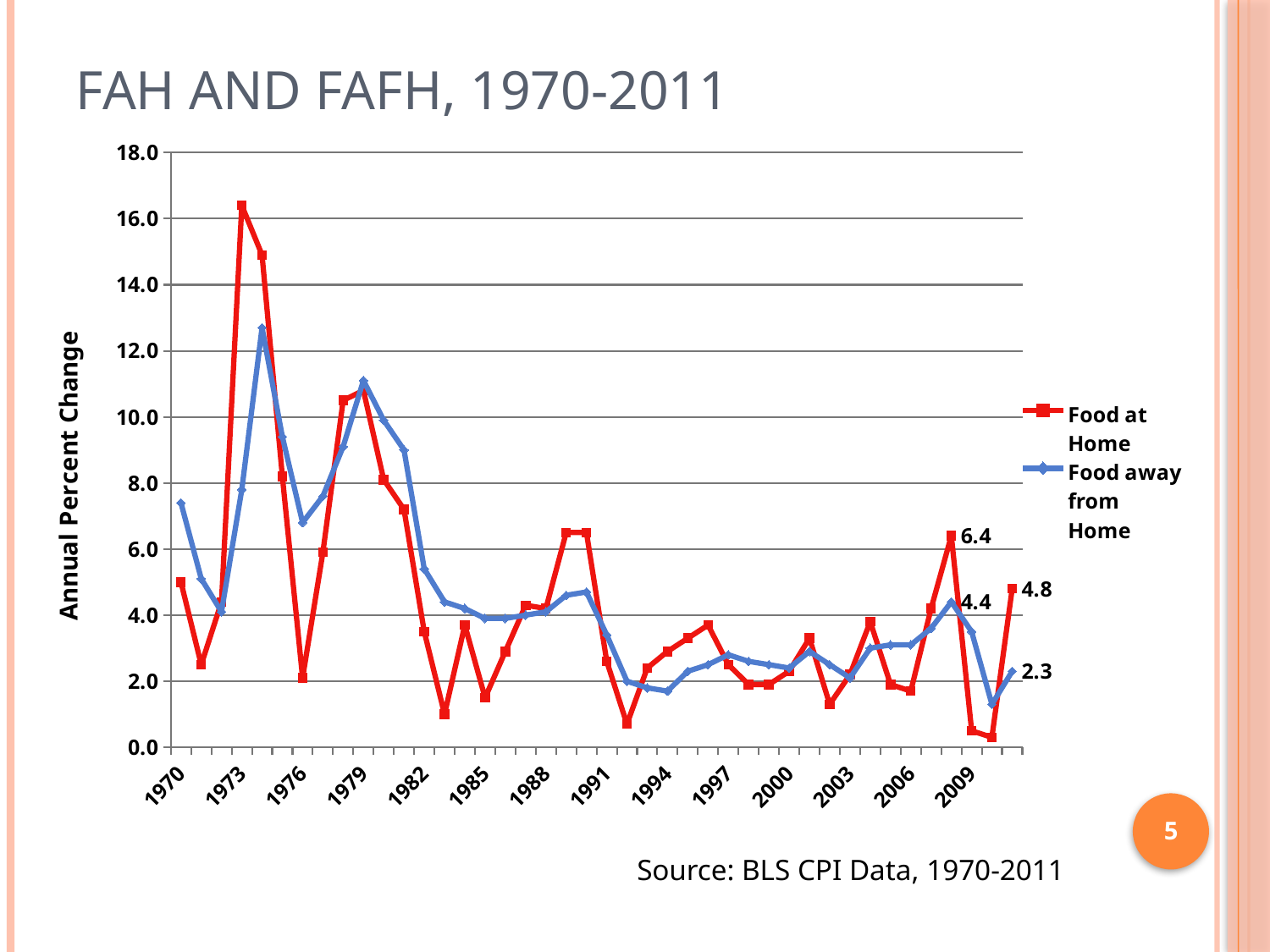
Is the value for Food away from Home in 1970 greater or less than 6.0? greater In 2011, which series has the larger value: Food at Home or Food away from Home? Food at Home In which year does the Food at Home series reach its highest value? 1973 What is the title of the vertical axis? Annual Percent Change How many series does the legend list? 2 Is the value for Food at Home in 1973 greater or less than 14.0? greater What is the labeled value for Food away from Home in 2011, the last year on the chart? 2.3 What is the labeled value for Food at Home in 2011, the last year on the chart? 4.8 What type of chart is shown on the slide? Line chart What is the highest labeled value shown for the Food at Home series? 6.4 What is the difference between the 2011 labeled values for Food at Home and Food away from Home? 2.5 What is the labeled value for Food away from Home at its 2008 peak? 4.4